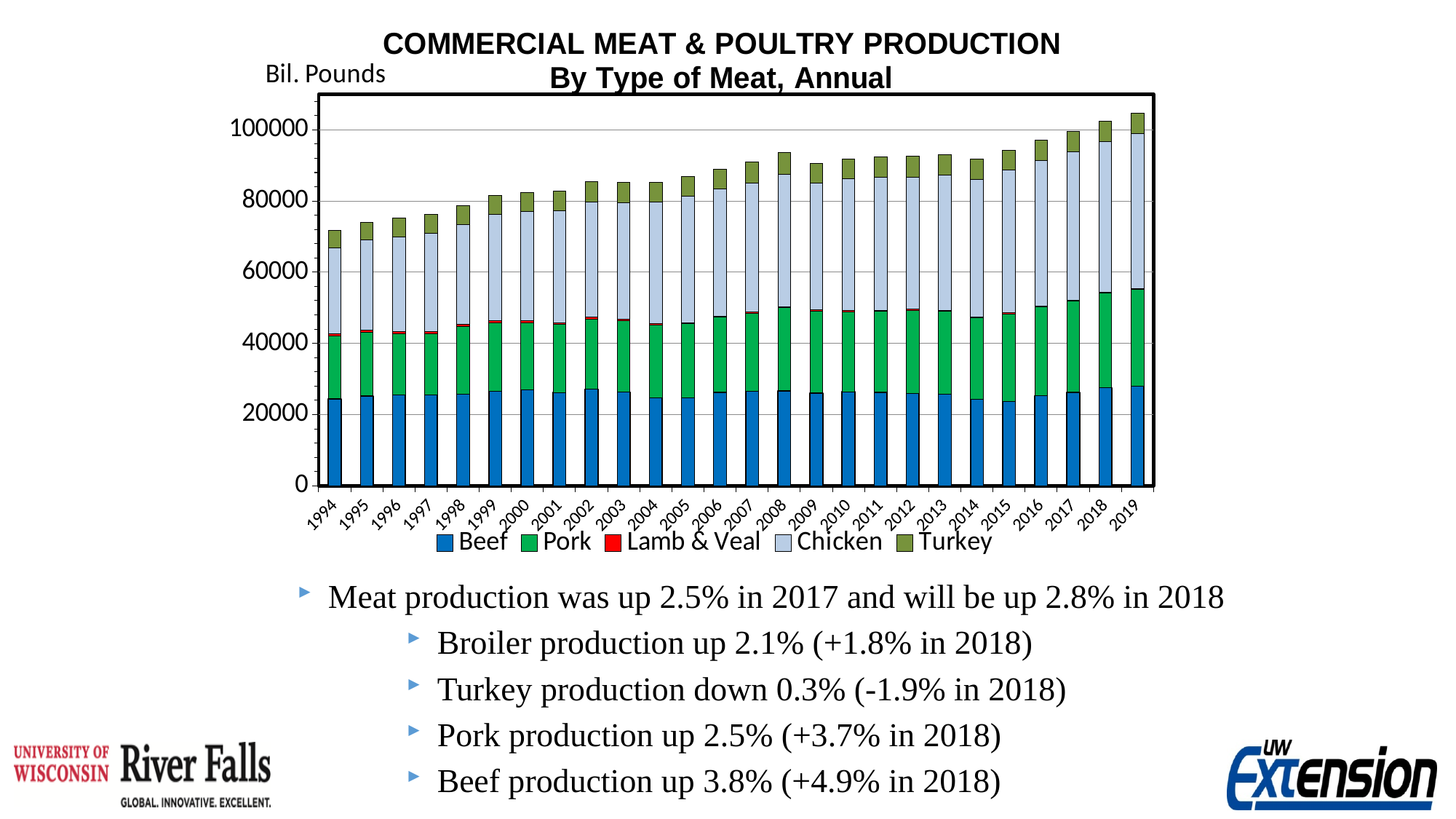
Which year has the highest total commercial meat and poultry production? 2019 Is the total production for 2017 greater or less than 80000? greater What kind of chart is shown on the slide? stacked bar chart Do total production values generally rise or fall from 1994 to 2019? rise Is the total production for 1994 greater or less than 80000? less Which series is shown in red in the legend? Lamb & Veal Is the total production for 2019 greater or less than 100000? greater Which year has the lowest total commercial meat and poultry production? 1994 Which year has the larger total production, 1994 or 2019? 2019 What unit is shown on the vertical axis of the chart? Bil. Pounds How many years are plotted along the x axis? 26 How many series does the legend list? 5